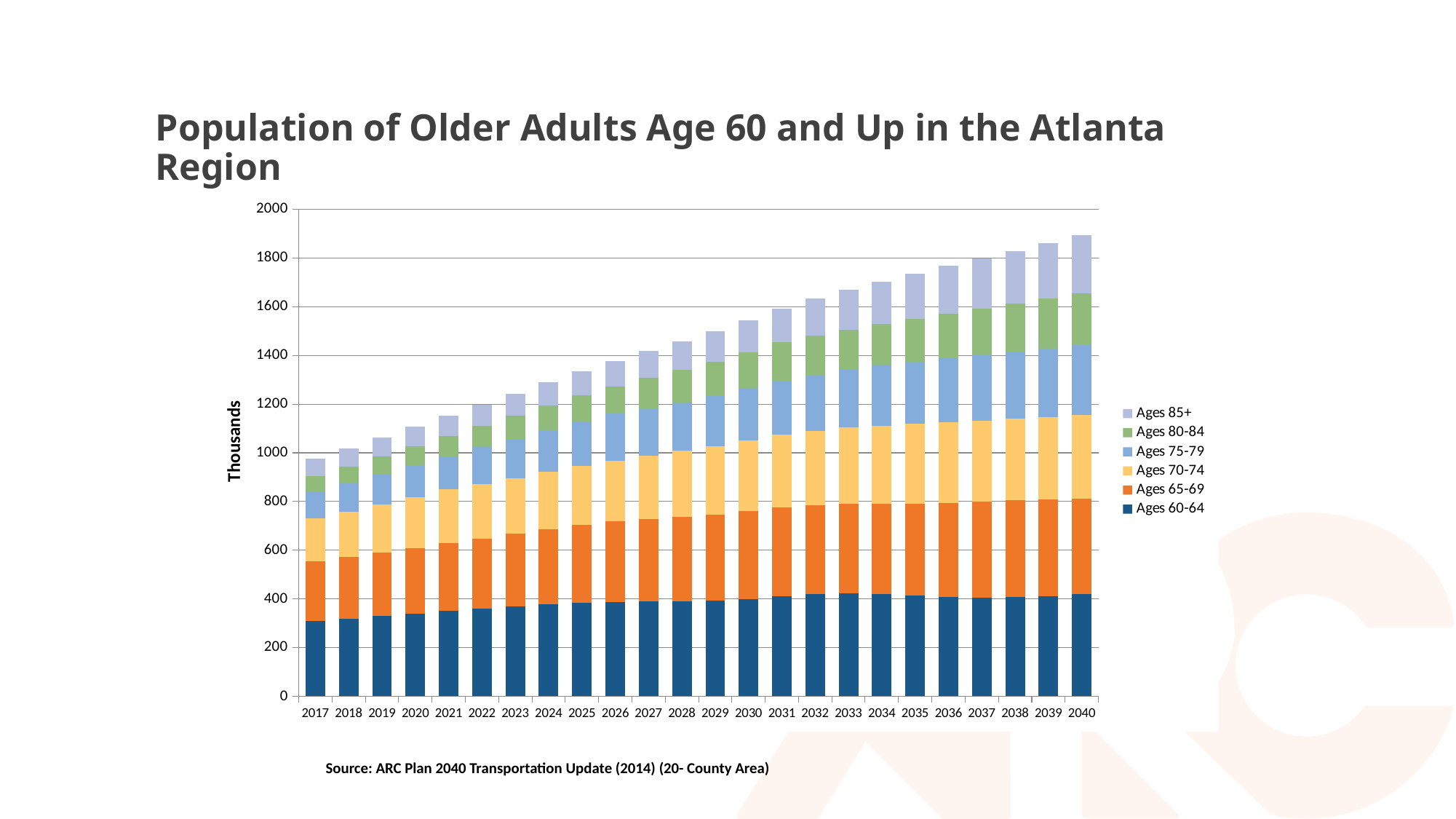
Do the total bar heights rise or fall from 2017 to 2040? rise Is the total stacked bar for 2017 greater or less than 1000? less Which legend entry is shown in the darkest blue at the bottom of each bar? Ages 60-64 Which total is larger, the bar for 2040 or the bar for 2017? 2040 Is the total stacked bar for 2030 greater or less than 1400? greater Which year has the lowest total stacked bar? 2017 Is the total stacked bar for 2040 greater or less than 1800? greater What kind of chart is shown on the slide? stacked bar chart What is the label on the vertical axis? Thousands How many years are shown along the x axis? 24 Which year has the highest total stacked bar? 2040 How many series does the legend list? 6